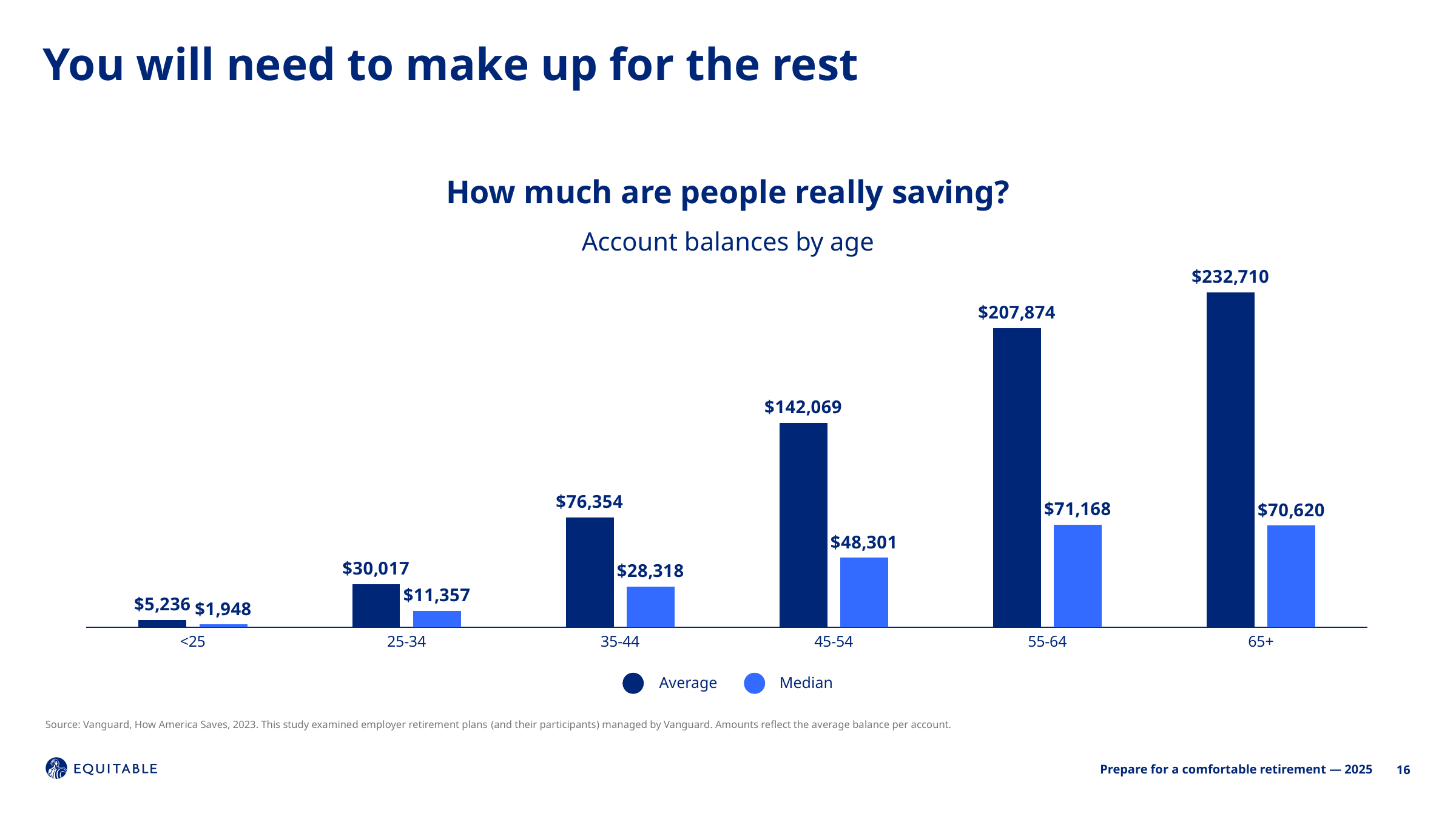
What is the Median account balance for the 65+ age group? $70,620 Which age group has the lowest Median account balance? <25 What is the Average account balance for the 45-54 age group? $142,069 Do the Average account balances rise or fall as age increases along the x axis? Rise What is the Median account balance for the 25-34 age group? $11,357 What is the subtitle of the chart below 'How much are people really saving?' Account balances by age How many series does the legend list? 2 What kind of chart is shown on the slide? Bar chart How many age groups are shown on the x axis? 6 Which is larger, the Average balance for 35-44 or the Median balance for 55-64? Average balance for 35-44 Which age group has the highest Average account balance? 65+ What is the difference between the Average and Median account balances for the 55-64 age group? $136,706